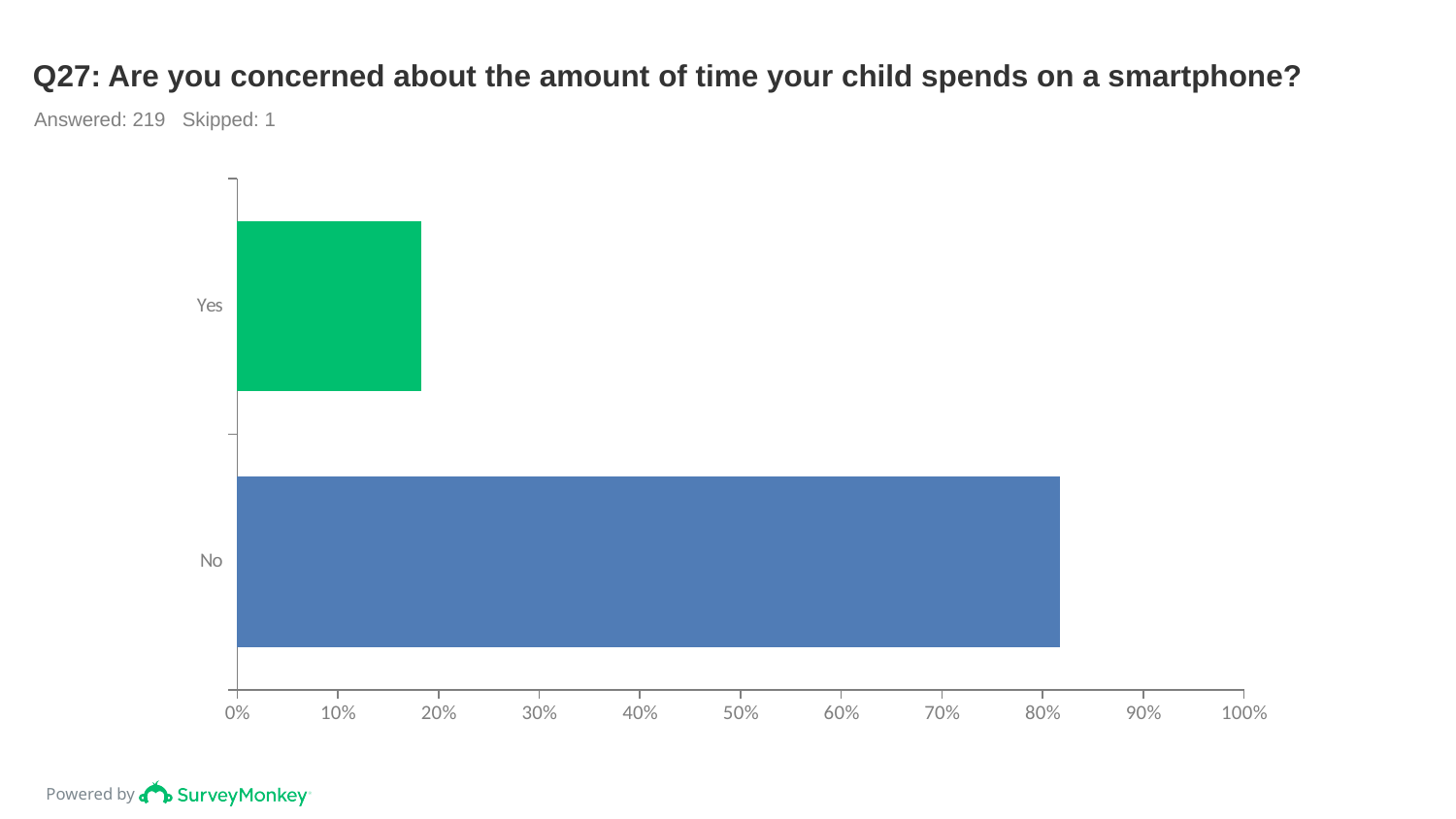
Is the value for Yes greater or less than 20%? less Is the value for Yes greater or less than 10%? greater What is the title of the chart? Q27: Are you concerned about the amount of time your child spends on a smartphone? Which is larger, the value for Yes or the value for No? No How many categories are plotted in the chart? 2 Which category has the highest value? No What kind of chart is shown on the slide? bar chart Which category has the lowest value? Yes Is the value for No greater or less than 90%? less How many respondents answered the question according to the slide? 219